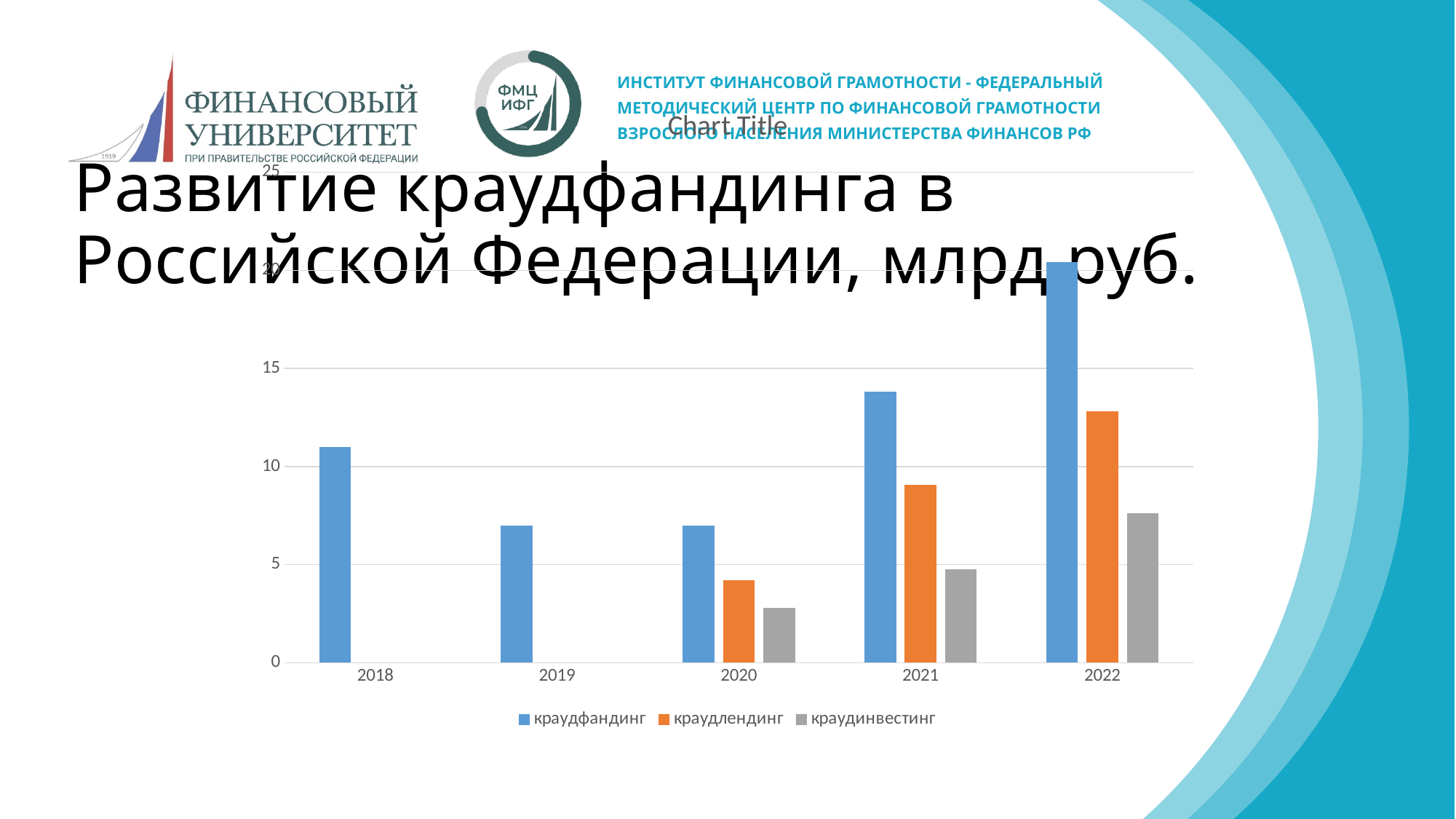
In 2021, which is larger: краудлендинг or краудинвестинг? краудлендинг Do the values for краудлендинг rise or fall from 2020 to 2022? rise Is the value for краудфандинг in 2018 greater or less than 10? greater How many series does the chart legend list? 3 In which year is the value for краудфандинг the highest? 2022 Is the value for краудлендинг in 2021 greater or less than 10? less In which year is the value for краудинвестинг the lowest? 2020 How many years are shown on the x axis of the chart? 5 Is the value for краудинвестинг in 2020 greater or less than 5? less What kind of chart is shown on the slide? bar chart Which year has the larger value for краудфандинг: 2018 or 2019? 2018